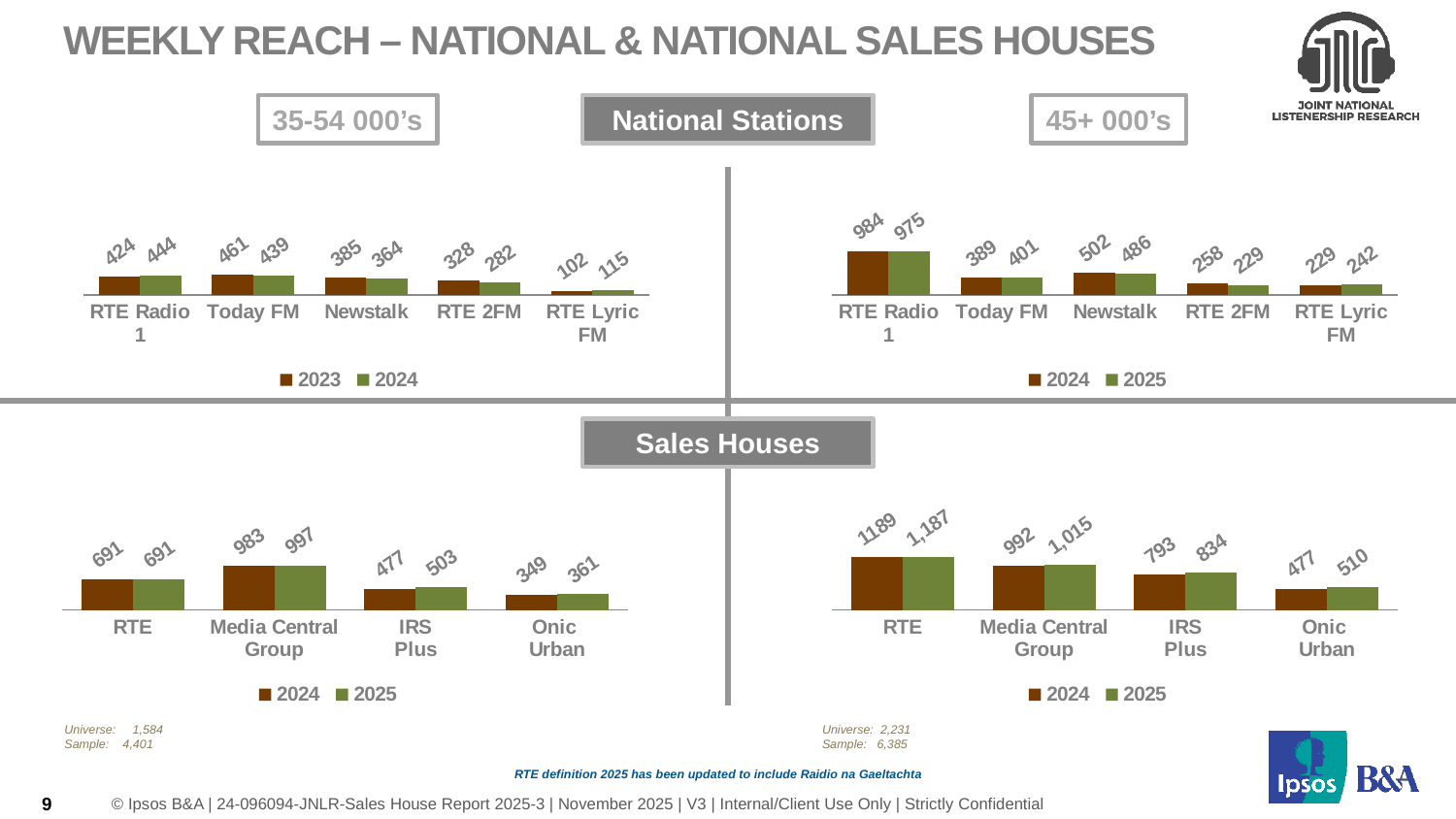
In the bottom-right Sales Houses chart (45+ 000's), what is the difference between the 2025 and 2024 values for Onic Urban? 33 In the top-right National Stations chart (45+ 000's), what is the 2025 value for Newstalk? 486 In the bottom-left Sales Houses chart (35-54 000's), how many sales houses are shown on the x axis? 4 In the top-left National Stations chart (35-54 000's), what is the 2024 value for RTE Radio 1? 444 In the bottom-left Sales Houses chart (35-54 000's), what is the 2025 value for IRS Plus? 503 In the bottom-right Sales Houses chart (45+ 000's), what is the 2025 value for Media Central Group? 1,015 In the top-left National Stations chart (35-54 000's), what is the difference between the 2023 and 2024 values for RTE 2FM? 46 In the top-right National Stations chart (45+ 000's), is the 2025 value for Today FM larger or smaller than its 2024 value? larger In the top-right National Stations chart (45+ 000's), which station has the highest 2024 value? RTE Radio 1 What type of chart is the top-left National Stations chart (35-54 000's)? Bar chart In the top-left National Stations chart (35-54 000's), which station has the lowest 2023 value? RTE Lyric FM How many series does the legend list in the bottom-right Sales Houses chart (45+ 000's)? 2